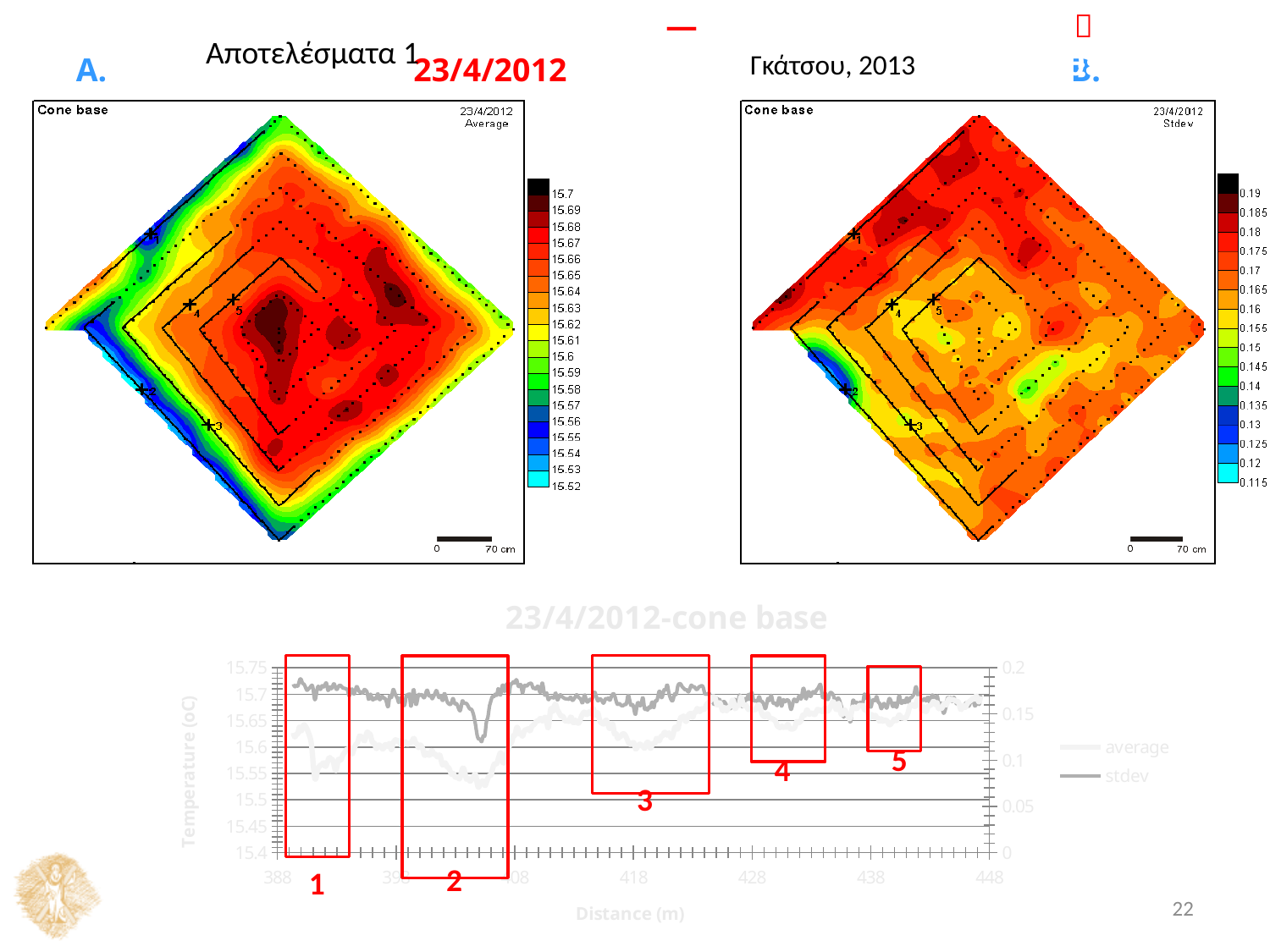
What is the x-axis label of the bottom chart "23/4/2012-cone base"? Distance (m) In the bottom chart "23/4/2012-cone base", is the stdev value at the start of the x axis (388 m) greater or less than 0.15 on the right axis? greater How many numbered red boxes are drawn on the bottom chart "23/4/2012-cone base"? 5 In the bottom chart "23/4/2012-cone base", is the lowest point of the average line inside red box 2 greater or less than 15.6? less What are the two series named in the legend of the bottom chart "23/4/2012-cone base"? average and stdev What is the highest value shown on the colour scale of the left contour map (A, Average)? 15.7 What is the lowest value shown on the colour scale of the right contour map (B, Stdev)? 0.115 What kind of chart is the bottom chart titled "23/4/2012-cone base"? line chart What is the highest value shown on the colour scale of the right contour map (B, Stdev)? 0.19 In the bottom chart "23/4/2012-cone base", is the average value at the start of the x axis (388 m) greater or less than 15.6? greater How many series does the legend of the bottom chart "23/4/2012-cone base" list? 2 What is the lowest value shown on the colour scale of the left contour map (A, Average)? 15.52